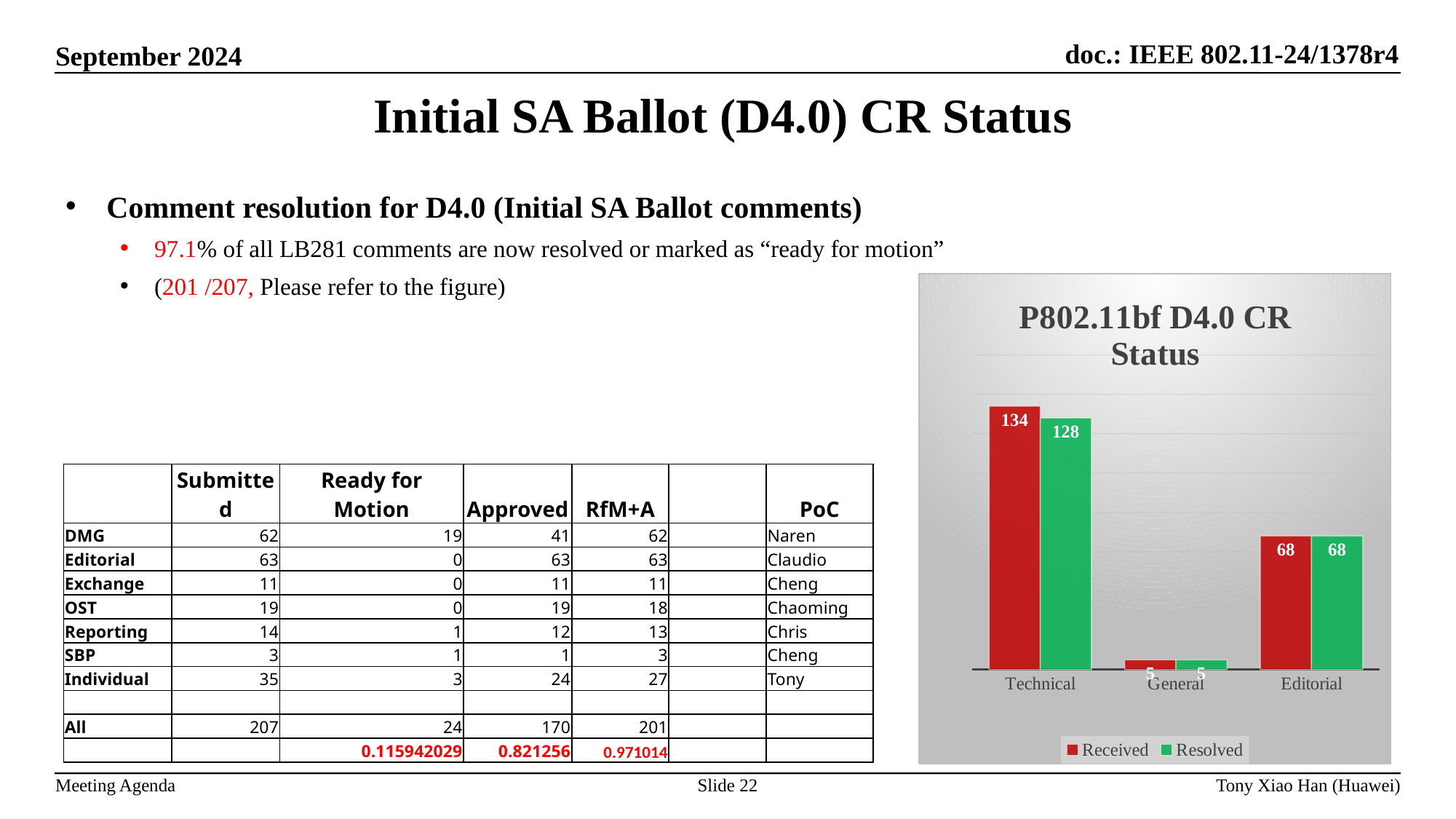
Which category has the highest Received value in the P802.11bf D4.0 CR Status chart? Technical What is the Received value for Technical in the P802.11bf D4.0 CR Status chart? 134 What is the Resolved value for Technical in the P802.11bf D4.0 CR Status chart? 128 What is the difference between the Received and Resolved values for Technical in the P802.11bf D4.0 CR Status chart? 6 What is the Resolved value for General in the P802.11bf D4.0 CR Status chart? 5 What kind of chart is the P802.11bf D4.0 CR Status chart? Bar chart How many categories are shown on the x axis of the P802.11bf D4.0 CR Status chart? 3 How many series does the legend of the P802.11bf D4.0 CR Status chart list? 2 What is the Received value for Editorial in the P802.11bf D4.0 CR Status chart? 68 What are the two series named in the legend of the P802.11bf D4.0 CR Status chart? Received and Resolved Which category has the lowest Resolved value in the P802.11bf D4.0 CR Status chart? General In the P802.11bf D4.0 CR Status chart, which is larger: the Received value for Technical or the Received value for Editorial? Technical